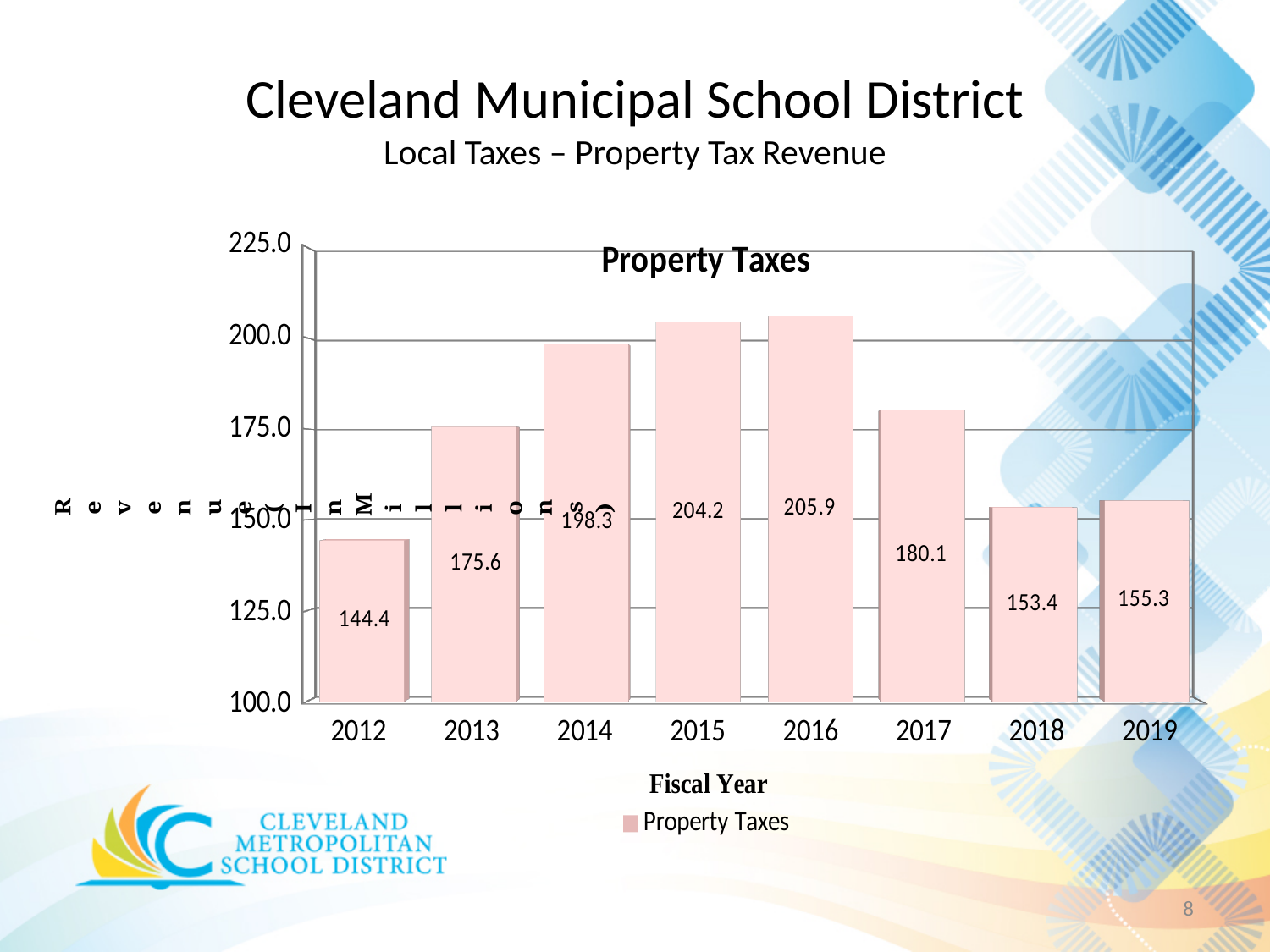
Is the value for 2015 greater or less than 200.0? greater What is the difference between the values for 2016 and 2012? 61.5 What is the difference between the values for 2014 and 2013? 22.7 Which is larger, the value for 2017 or the value for 2018? 2017 What is the value for 2016 in the Property Taxes chart? 205.9 Which fiscal year has the lowest property tax value? 2012 How many fiscal years are shown on the x axis? 8 What is the x-axis title of the chart? Fiscal Year What is the value for 2019 in the Property Taxes chart? 155.3 What kind of chart is shown on the slide? bar chart What is the value for 2012 in the Property Taxes chart? 144.4 Which fiscal year has the highest property tax value? 2016